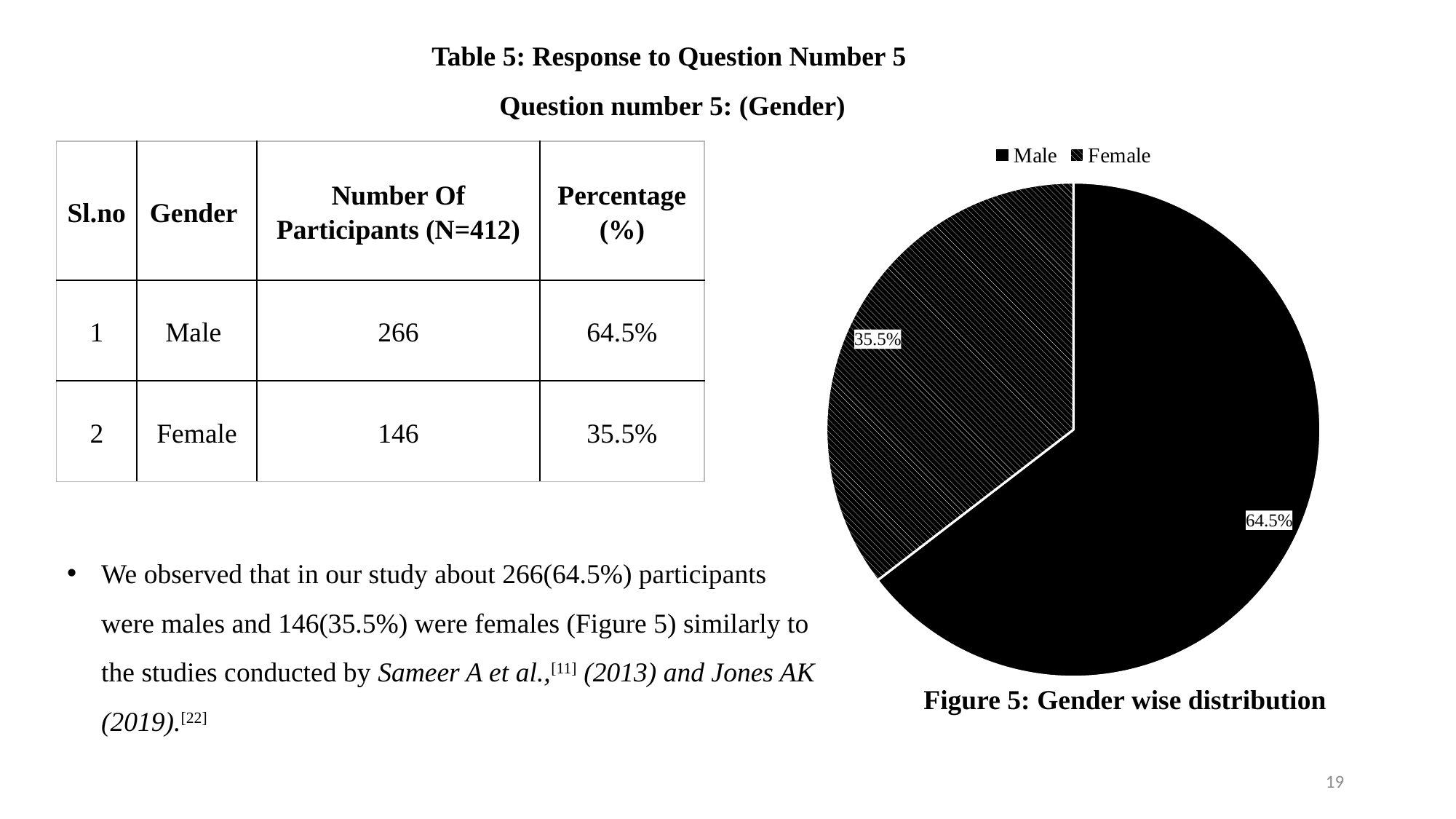
How many entries does the legend of the pie chart list? 2 What kind of chart is shown in Figure 5? pie chart How many slices does the pie chart have? 2 What share of the pie chart does the Female slice represent? 35.5% Which is larger in the pie chart, the Male slice or the Female slice? Male What is the difference in percentage points between the Male and Female slices of the pie chart? 29 percentage points What is the caption of the pie chart? Figure 5: Gender wise distribution Which slice of the pie chart is drawn with a hatched pattern? Female Which slice of the pie chart is the smallest? Female Which slice of the pie chart is the largest? Male What share of the pie chart does the Male slice represent? 64.5%